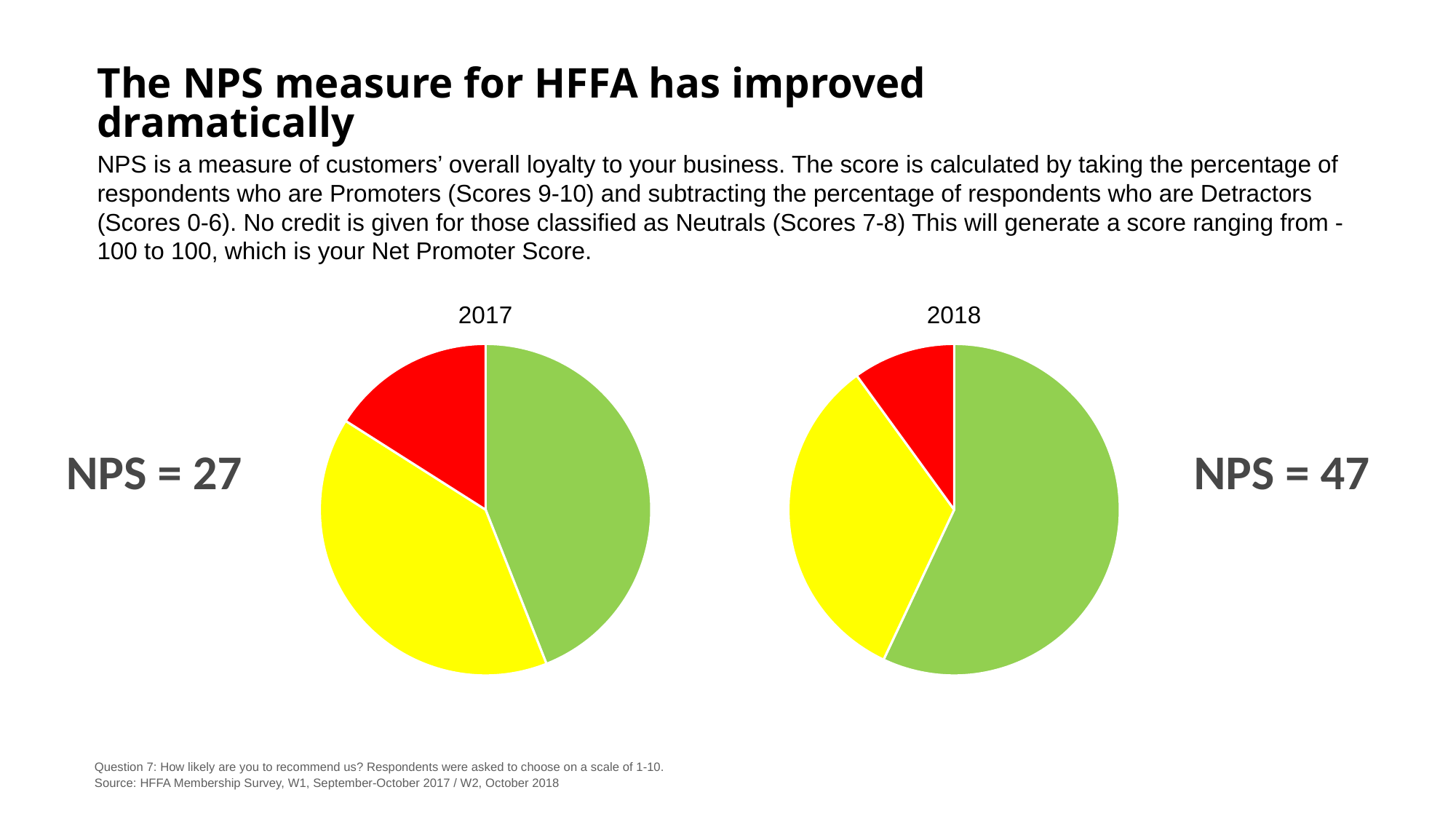
What is the NPS value shown next to the 2017 pie chart? 27 What kind of chart is used to show the 2017 and 2018 results on the slide? Pie chart By how much did the NPS shown on the slide increase from 2017 to 2018? 20 How many slices does the 2018 pie chart have? 3 What are the titles of the two pie charts on the slide? 2017 and 2018 Which year has the higher NPS shown on the slide, 2017 or 2018? 2018 In the 2017 pie chart, which colour slice is the largest? Green In the 2018 pie chart, is the green slice larger or smaller than the yellow slice? Larger In the 2018 pie chart, which colour slice is the smallest? Red What is the NPS value shown next to the 2018 pie chart? 47 How many slices does the 2017 pie chart have? 3 How many pie charts are shown on the slide? 2